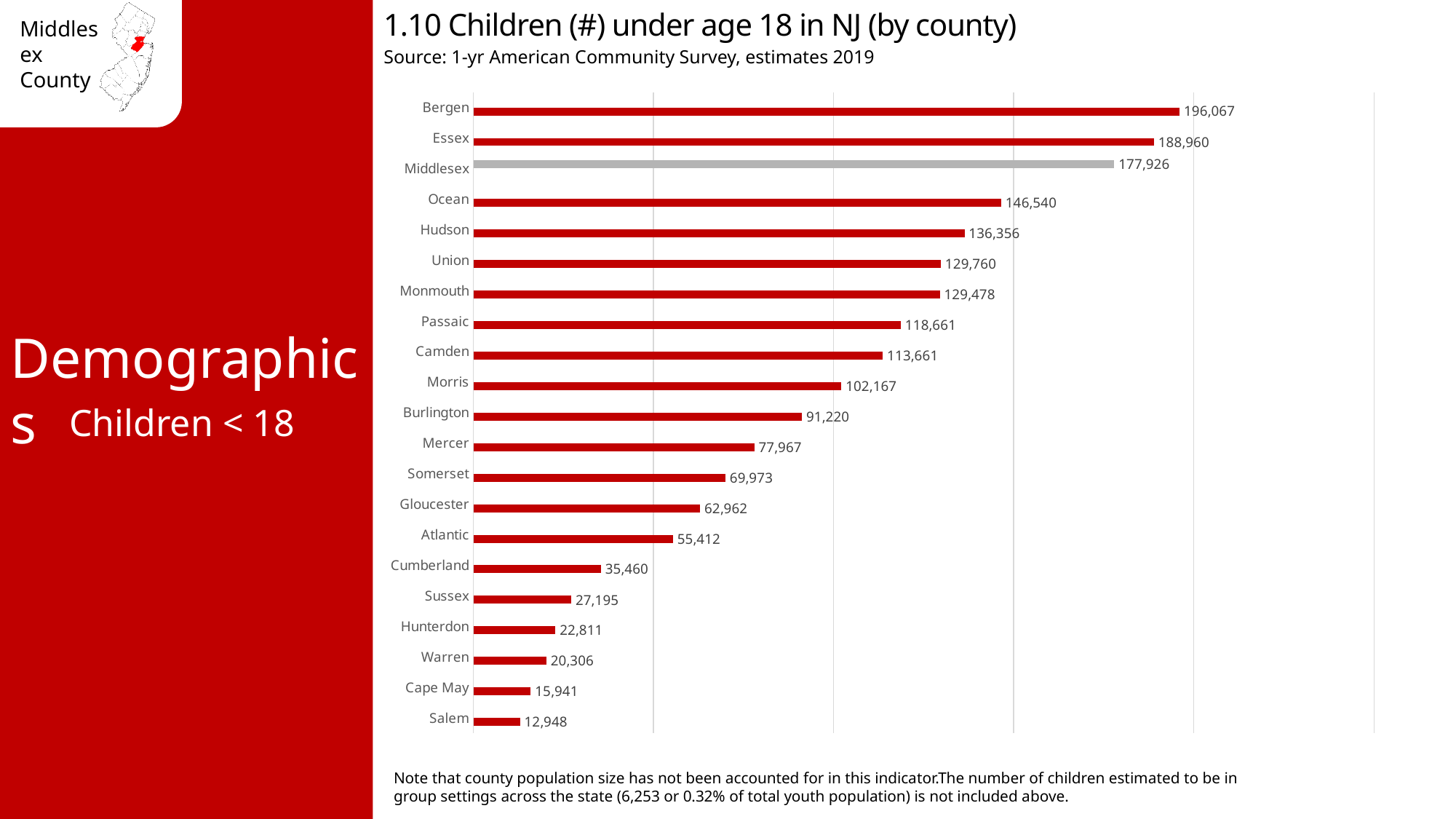
Which county has the highest number of children under age 18? Bergen Which county has a larger value, Hudson or Passaic? Hudson How many counties are shown in the chart? 21 What type of chart is shown on the slide? Bar chart What is the difference between the values for Middlesex and Ocean? 31,386 Which county has the lowest number of children under age 18? Salem Are the bars ordered from largest to smallest or smallest to largest going down the chart? Largest to smallest How many children under age 18 are in Middlesex County? 177,926 What is the difference between the values for Bergen and Essex? 7,107 What is the value for Cumberland County? 35,460 What is the value for Ocean County? 146,540 Which county's bar is shown in grey instead of red? Middlesex